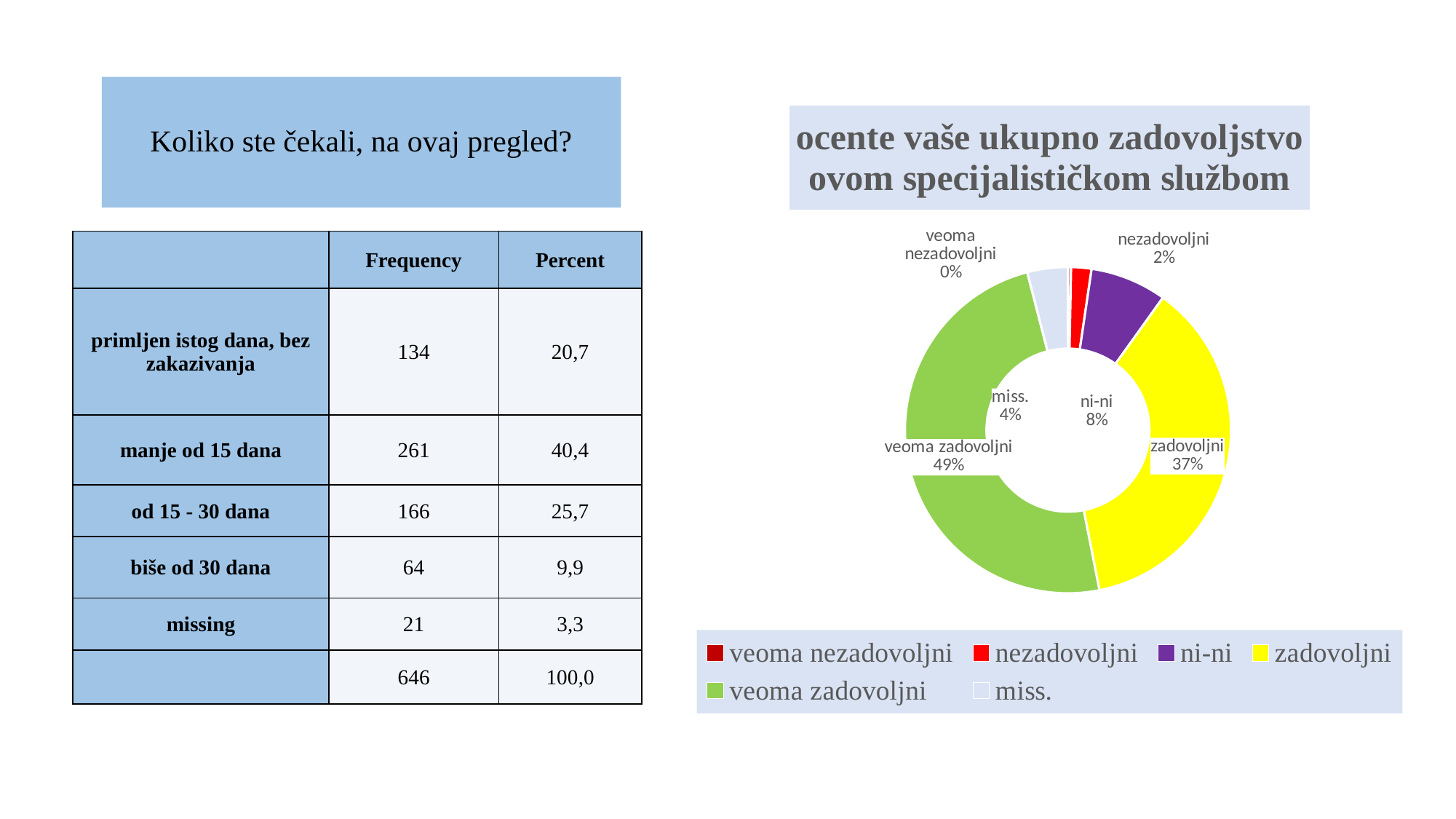
Which category has the largest share in the doughnut chart? veoma zadovoljni What kind of chart is shown on the right side of the slide? doughnut chart In the doughnut chart, what share is labelled for 'veoma nezadovoljni'? 0% How many entries does the legend of the doughnut chart list? 6 In the doughnut chart, which is larger: 'ni-ni' or 'miss.'? ni-ni In the doughnut chart, what share is labelled for 'ni-ni'? 8% Which category has the smallest share in the doughnut chart? veoma nezadovoljni In the doughnut chart, what share is labelled for 'miss.'? 4% In the doughnut chart, what share is labelled for 'zadovoljni'? 37% In the doughnut chart, what is the difference in percentage points between 'veoma zadovoljni' and 'zadovoljni'? 12 In the doughnut chart, what share is labelled for 'nezadovoljni'? 2% In the doughnut chart, what share is labelled for 'veoma zadovoljni'? 49%